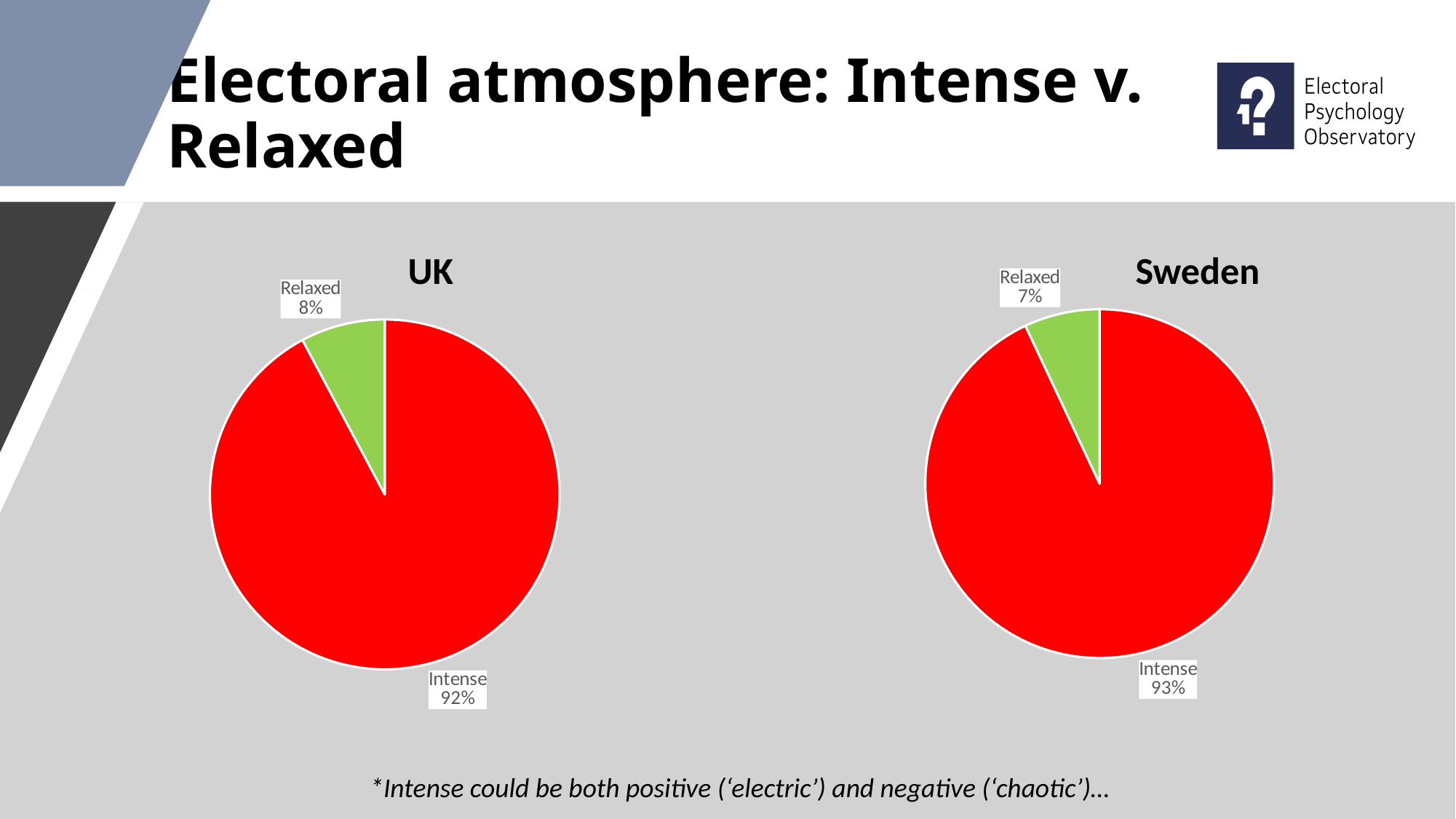
How many slices does the Sweden chart have? 2 In the UK chart, what is the difference between the Intense and Relaxed shares? 84% In the UK chart, what share of the pie is labelled Intense? 92% In the UK chart, what colour is the Relaxed slice? Green In the UK chart, what share of the pie is labelled Relaxed? 8% In the Sweden chart, what share of the pie is labelled Intense? 93% Which chart has the larger Relaxed share, UK or Sweden? UK In the Sweden chart, what is the difference between the Intense and Relaxed shares? 86% What kind of chart is the UK chart? Pie chart In the Sweden chart, which slice is the smallest? Relaxed In the UK chart, which slice is the largest? Intense